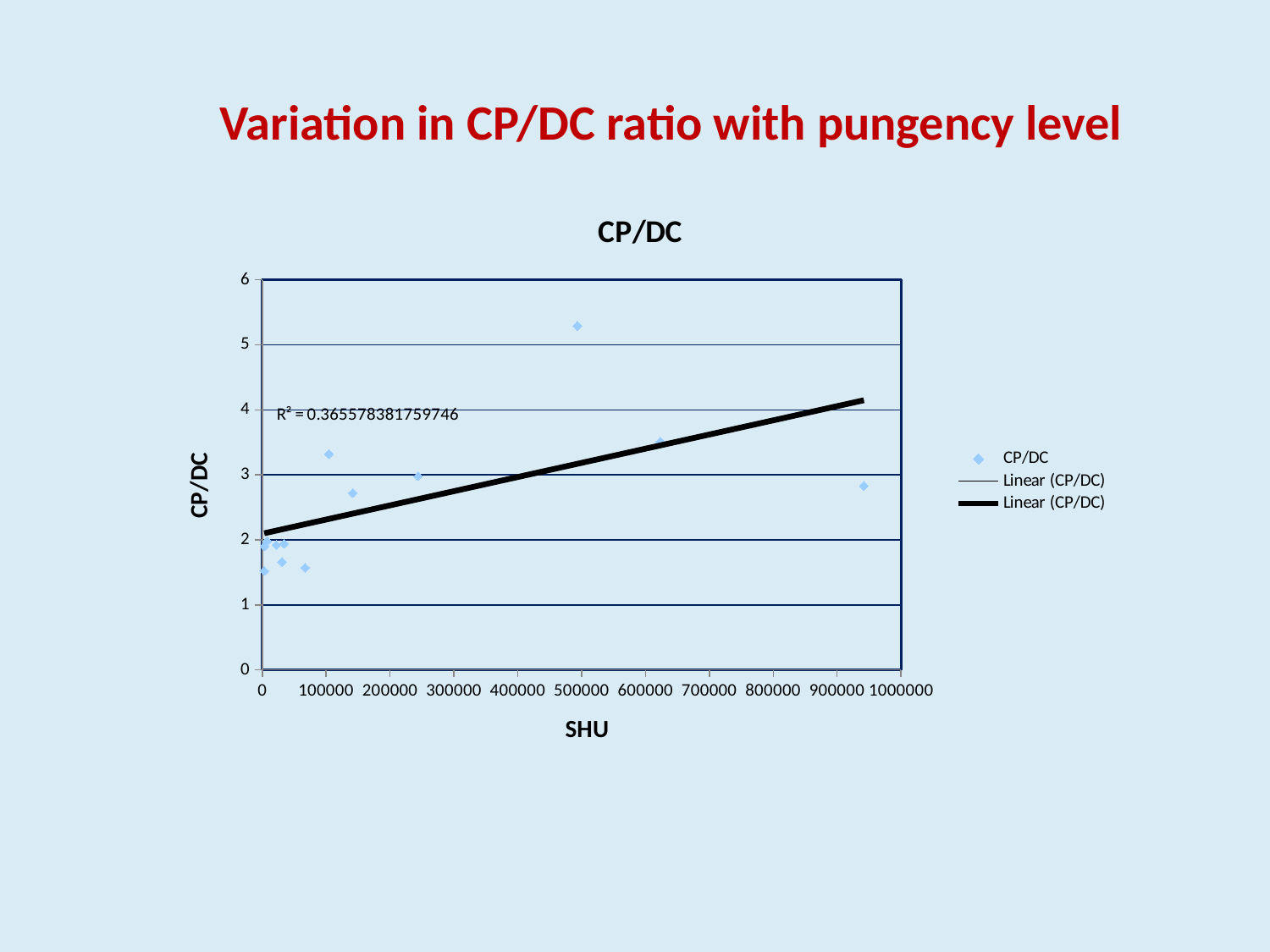
What R² value is printed on the chart? R² = 0.365578381759746 What is the maximum value shown on the y axis? 6 What kind of chart is shown on the slide? scatter chart Which has the higher CP/DC value: the data point near 500000 SHU or the data point near 940000 SHU? the data point near 500000 SHU Is the CP/DC value of the highest data point (near 500000 SHU) greater or less than 5? greater What is the title of the chart? CP/DC Is the CP/DC value of the data point near 100000 SHU greater or less than 3? greater Is the CP/DC value of the data point near 940000 SHU greater or less than 3? less How many entries does the legend list? 3 What is the label of the x axis? SHU Does the linear trendline rise or fall as SHU increases? rises